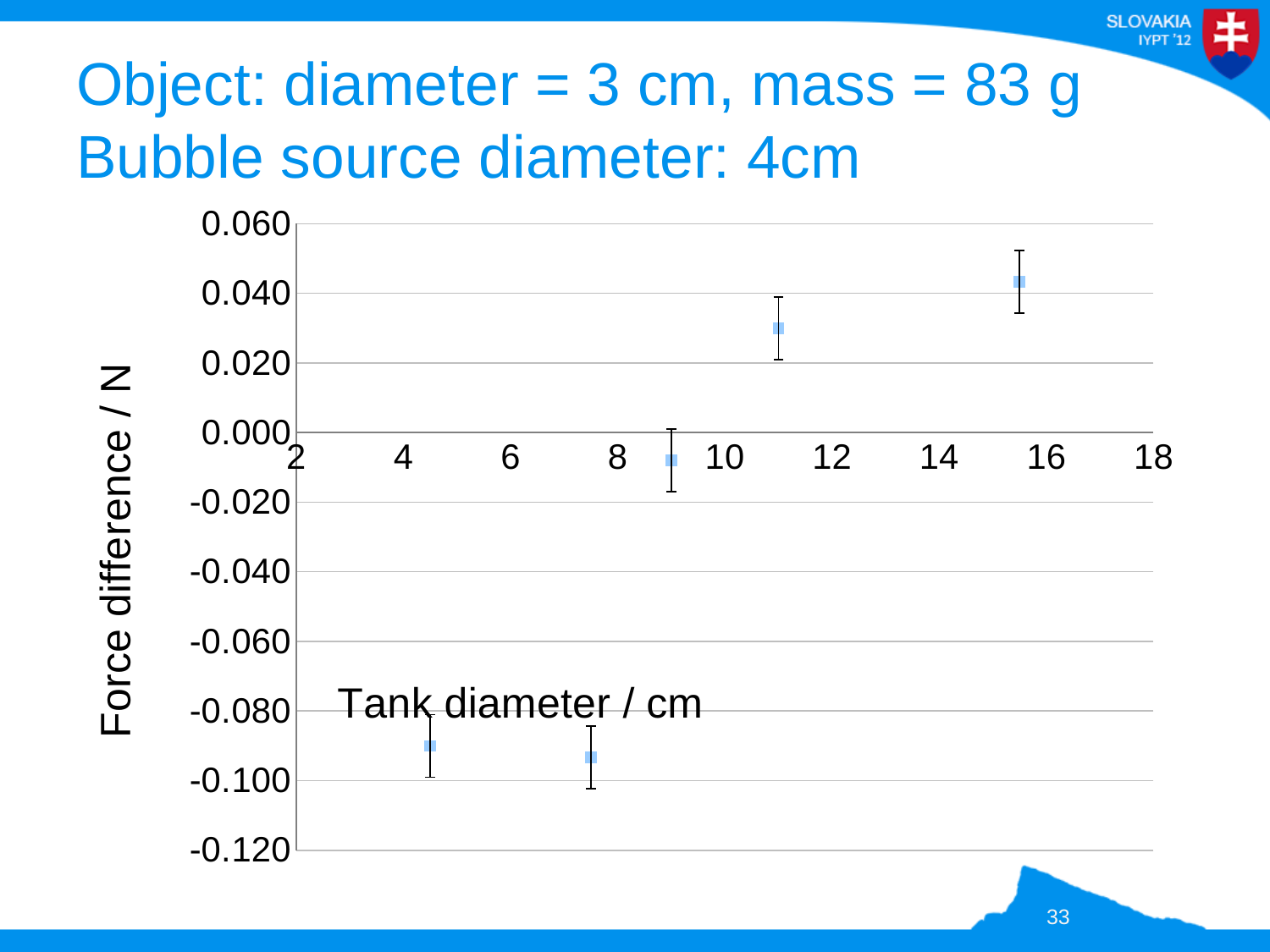
What kind of chart is shown on the slide? scatter plot How many data points are plotted on the chart? 5 What is the label of the vertical axis? Force difference / N Is the force difference for the data point between 8 and 10 cm tank diameter greater or less than 0.000 N? less Is the force difference for the data point between 4 and 6 cm tank diameter greater or less than -0.080 N? less Which data point has the highest force difference: the one near 4 cm, 8 cm, 10 cm, 12 cm or 16 cm tank diameter? the one near 16 cm Which has the larger force difference: the data point between 4 and 6 cm tank diameter or the one between 14 and 16 cm? the one between 14 and 16 cm Is the force difference for the data point between 10 and 12 cm tank diameter greater or less than 0.020 N? greater What is the label of the horizontal axis? Tank diameter / cm Which has the larger force difference: the data point between 8 and 10 cm tank diameter or the one between 10 and 12 cm? the one between 10 and 12 cm Does the force difference generally rise or fall as the tank diameter increases? rise